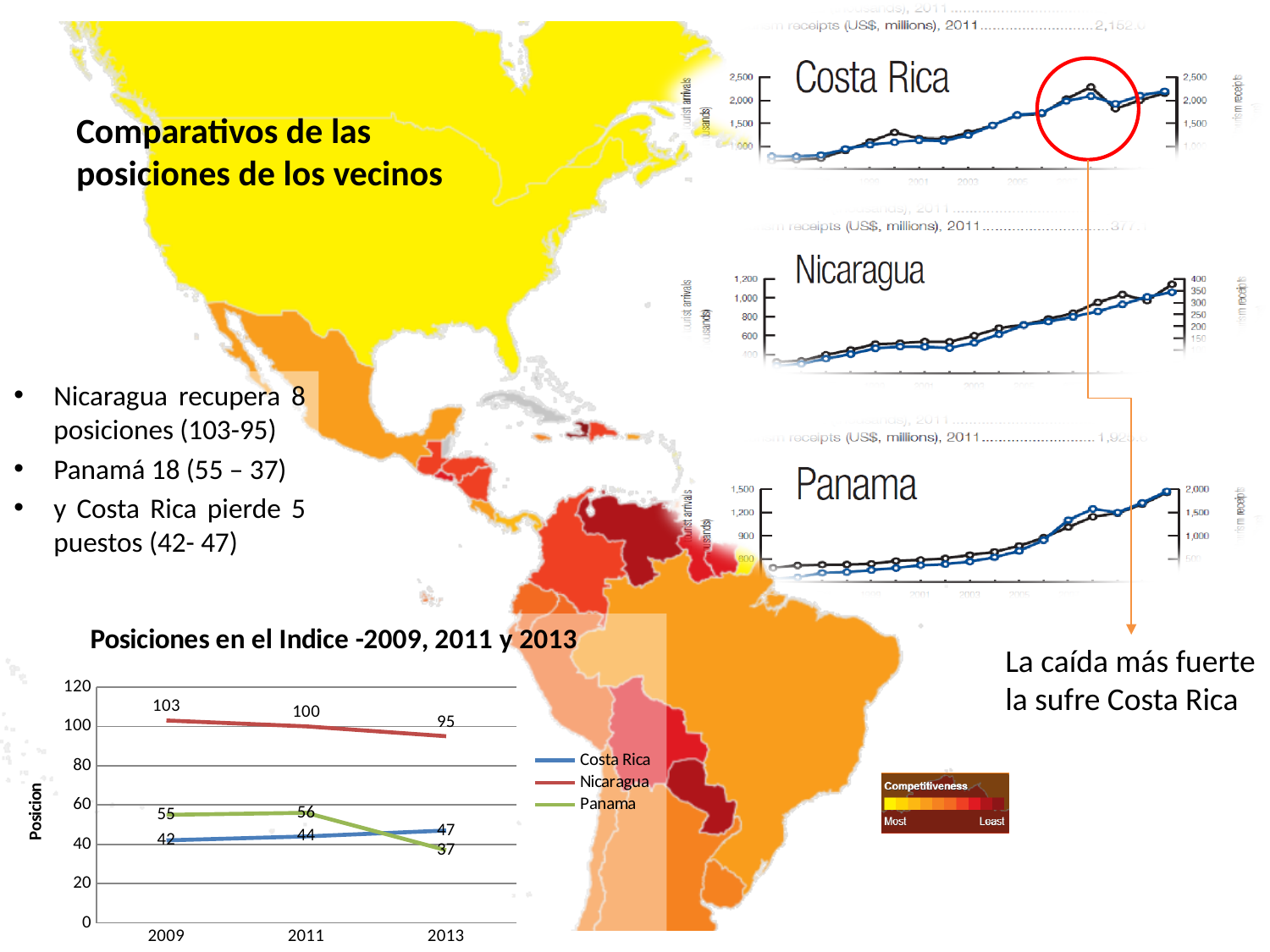
In the chart titled 'Posiciones en el Indice -2009, 2011 y 2013', how many years are shown on the x axis? 3 In the chart titled 'Posiciones en el Indice -2009, 2011 y 2013', what is the value for Nicaragua in 2009? 103 In the chart titled 'Posiciones en el Indice -2009, 2011 y 2013', which series has the lowest value in 2013? Panama In the chart titled 'Posiciones en el Indice -2009, 2011 y 2013', what is the difference between Panama's value in 2011 and in 2013? 19 What kind of chart is 'Posiciones en el Indice -2009, 2011 y 2013'? Line chart In the chart titled 'Posiciones en el Indice -2009, 2011 y 2013', how many series does the legend list? 3 In the chart titled 'Posiciones en el Indice -2009, 2011 y 2013', do the values for Costa Rica rise or fall from 2009 to 2013? Rise In the chart titled 'Posiciones en el Indice -2009, 2011 y 2013', which is larger in 2009: the value for Costa Rica or the value for Panama? Panama In the chart titled 'Posiciones en el Indice -2009, 2011 y 2013', what is the value for Costa Rica in 2011? 44 In the chart titled 'Posiciones en el Indice -2009, 2011 y 2013', which series has the highest value in 2013? Nicaragua In the chart titled 'Posiciones en el Indice -2009, 2011 y 2013', what is the value for Panama in 2013? 37 In the chart titled 'Posiciones en el Indice -2009, 2011 y 2013', what is the difference between Nicaragua's value in 2009 and in 2013? 8